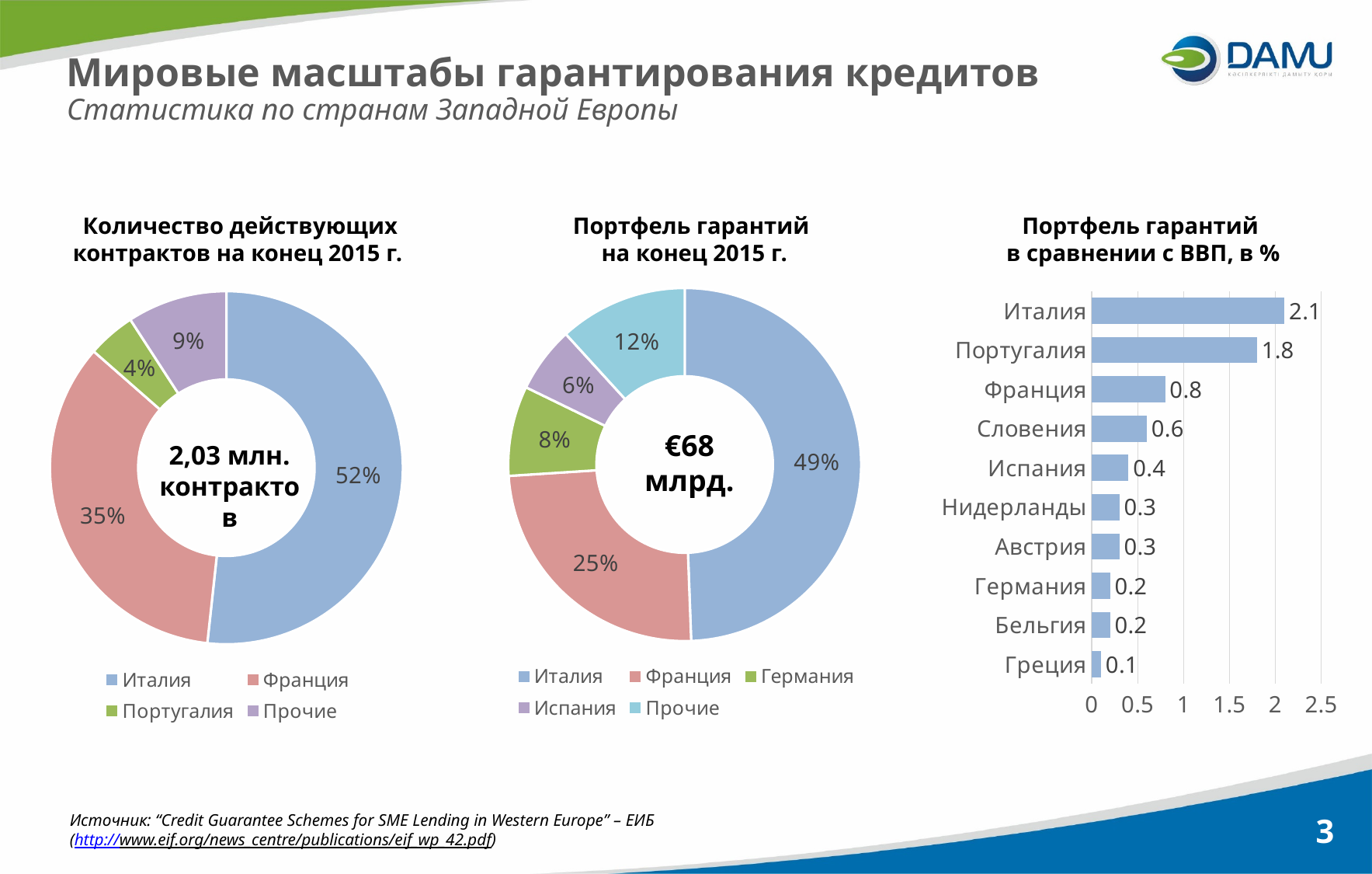
In the chart 'Количество действующих контрактов на конец 2015 г.', what share does Италия have? 52% In the chart 'Количество действующих контрактов на конец 2015 г.', which category has the smallest share? Португалия What kind of chart is 'Портфель гарантий в сравнении с ВВП, в %'? bar chart In the chart 'Портфель гарантий в сравнении с ВВП, в %', what is the value for Португалия? 1.8 In the chart 'Портфель гарантий на конец 2015 г.', what is the difference between the shares of Италия and Франция? 24% In the chart 'Количество действующих контрактов на конец 2015 г.', how many categories does the legend list? 4 In the chart 'Портфель гарантий в сравнении с ВВП, в %', which country has the highest value? Италия In the chart 'Портфель гарантий на конец 2015 г.', what total value is shown in the centre of the donut? €68 млрд. In the chart 'Портфель гарантий в сравнении с ВВП, в %', what is the difference between the values for Италия and Франция? 1.3 In the chart 'Портфель гарантий в сравнении с ВВП, в %', how many countries are shown? 10 In the chart 'Портфель гарантий на конец 2015 г.', which is larger: the share of Германия or the share of Испания? Германия In the chart 'Портфель гарантий на конец 2015 г.', what share does Франция have? 25%